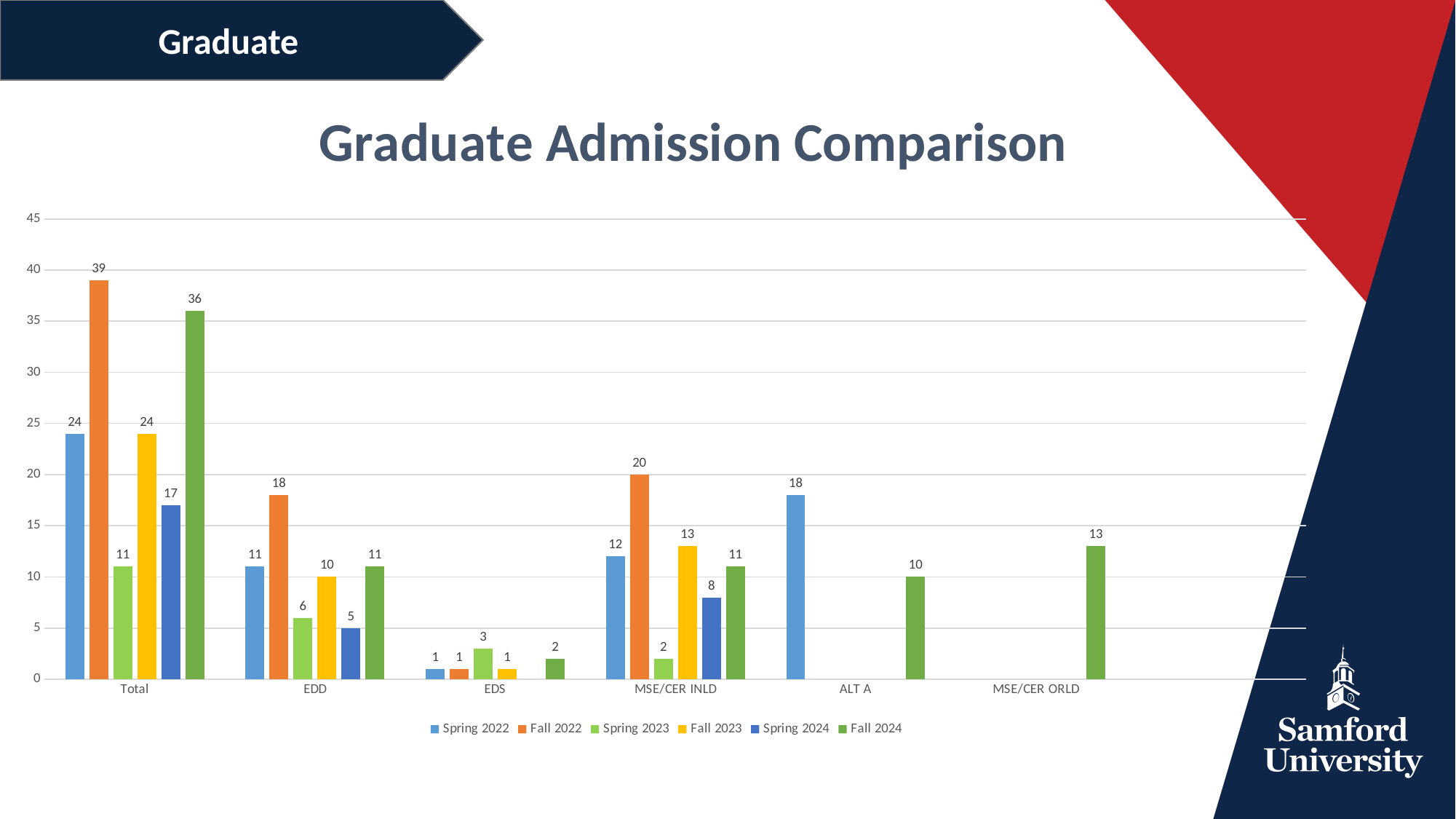
What is the Spring 2024 value for EDD? 5 Which is larger for MSE/CER INLD, Fall 2022 or Fall 2023? Fall 2022 Which category has the highest Fall 2024 value? Total What is the title of the chart? Graduate Admission Comparison What is the difference between the Fall 2022 and Fall 2024 values for Total? 3 Which series has the lowest value for Total? Spring 2023 What kind of chart is shown? Bar chart How many series does the legend list? 6 What is the Fall 2022 value for Total? 39 What is the Spring 2022 value for ALT A? 18 How many categories are shown on the x axis? 6 What is the Fall 2024 value for MSE/CER ORLD? 13